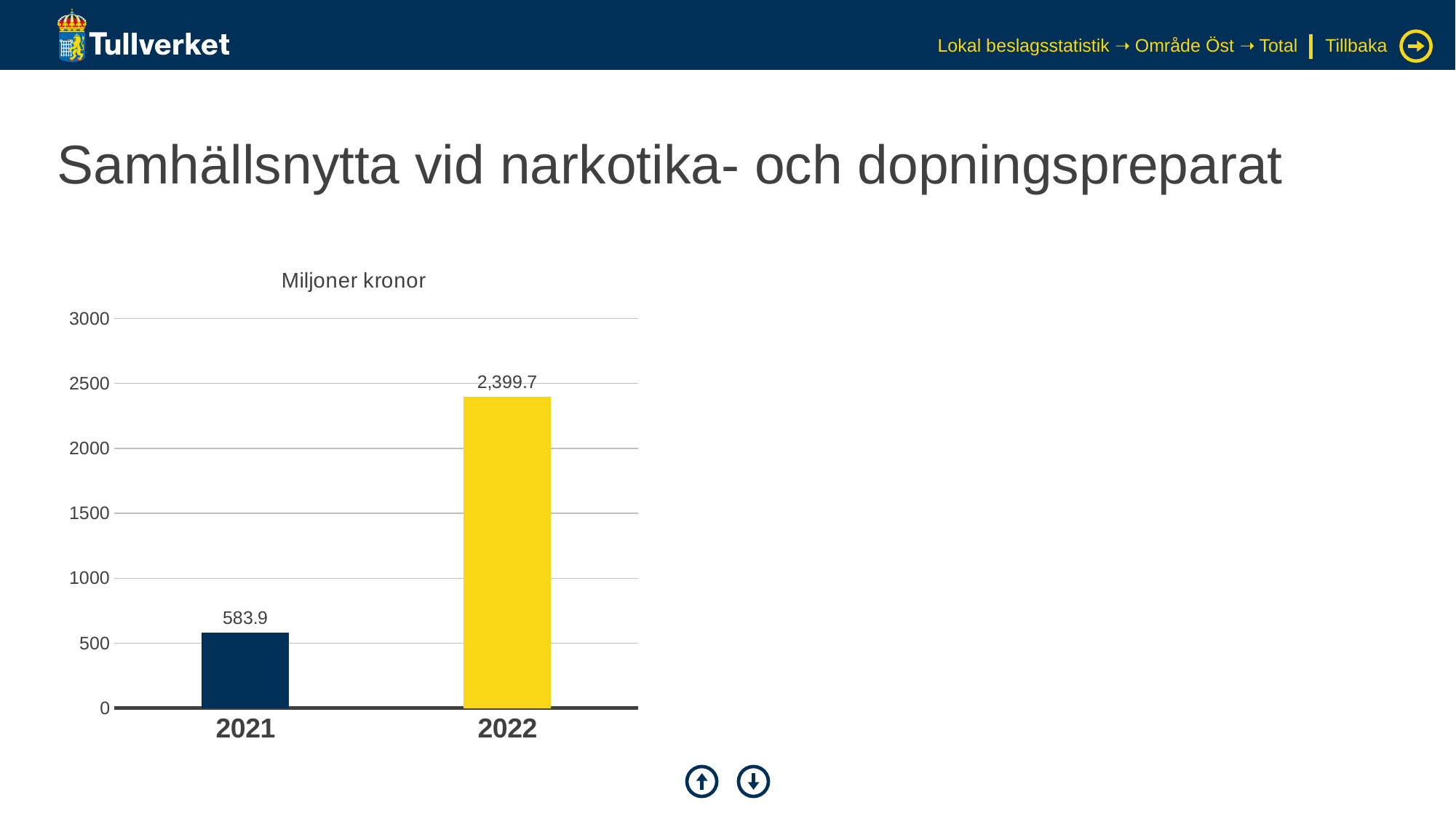
Is the value for 2021 greater or less than 1000? less How many years are shown on the x axis? 2 What is the difference between the values for 2022 and 2021? 1,815.8 What is the value for 2022? 2,399.7 What kind of chart is shown on the slide? bar chart What unit label is shown above the chart? Miljoner kronor Which year has the lowest value? 2021 Which is larger, the value for 2021 or the value for 2022? 2022 Do the values rise or fall from 2021 to 2022? rise What is the value for 2021? 583.9 Is the value for 2022 greater or less than 2000? greater Which year has the highest value? 2022